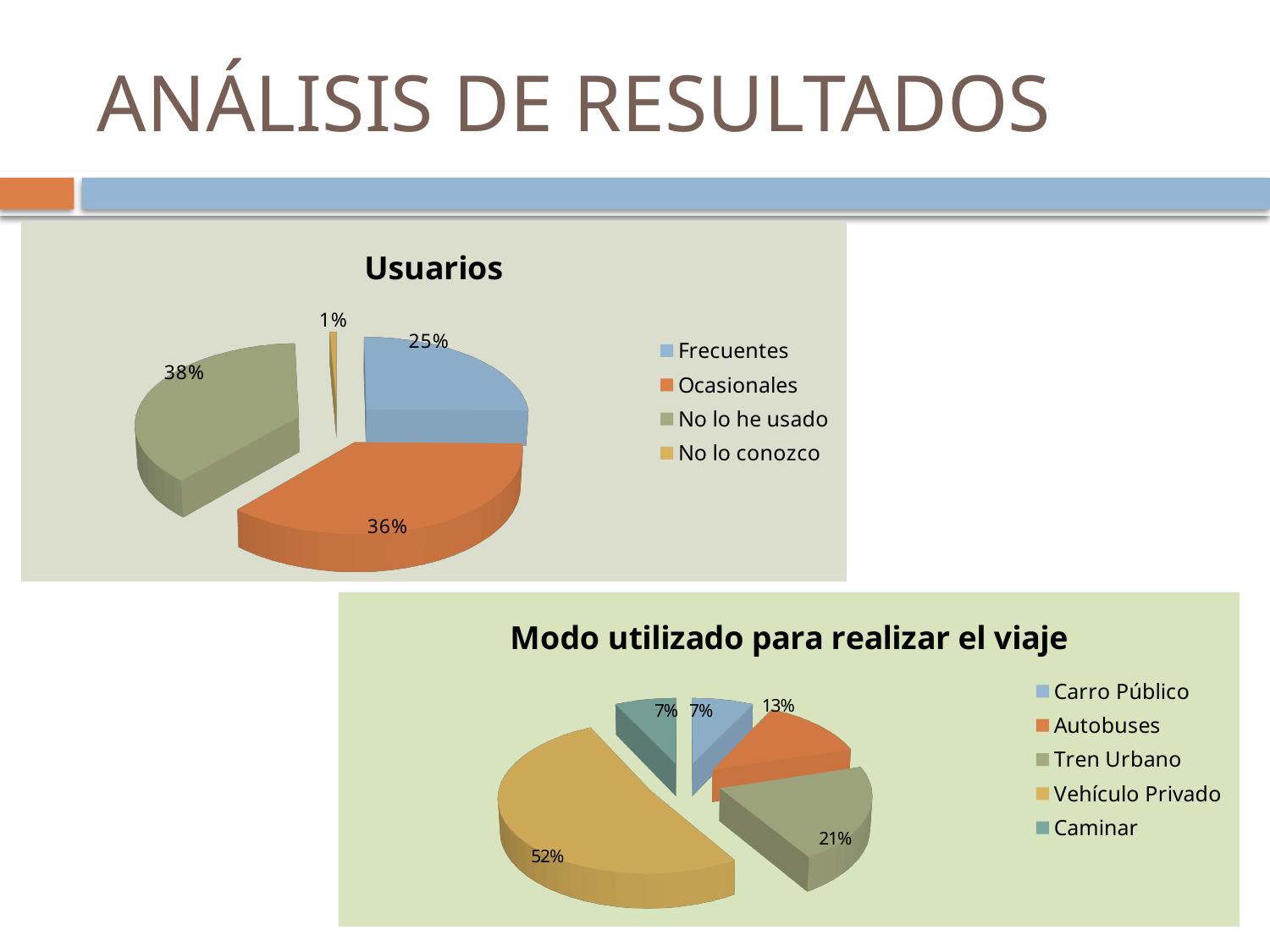
In the 'Usuarios' chart, what is the difference in percentage points between Ocasionales and Frecuentes? 11 In the 'Usuarios' chart, what percentage is shown for Frecuentes? 25% In the 'Modo utilizado para realizar el viaje' chart, which is larger, Autobuses or Tren Urbano? Tren Urbano In the 'Usuarios' chart, what percentage is shown for No lo he usado? 38% In the 'Modo utilizado para realizar el viaje' chart, how many categories does the legend list? 5 What kind of chart is 'Modo utilizado para realizar el viaje'? Pie chart In the 'Modo utilizado para realizar el viaje' chart, what percentage is shown for Tren Urbano? 21% In the 'Usuarios' chart, which category has the smallest share? No lo conozco In the 'Usuarios' chart, which category has the largest share? No lo he usado In the 'Modo utilizado para realizar el viaje' chart, what percentage is shown for Vehículo Privado? 52% In the 'Usuarios' chart, how many categories does the legend list? 4 In the 'Modo utilizado para realizar el viaje' chart, what is the difference in percentage points between Vehículo Privado and Tren Urbano? 31